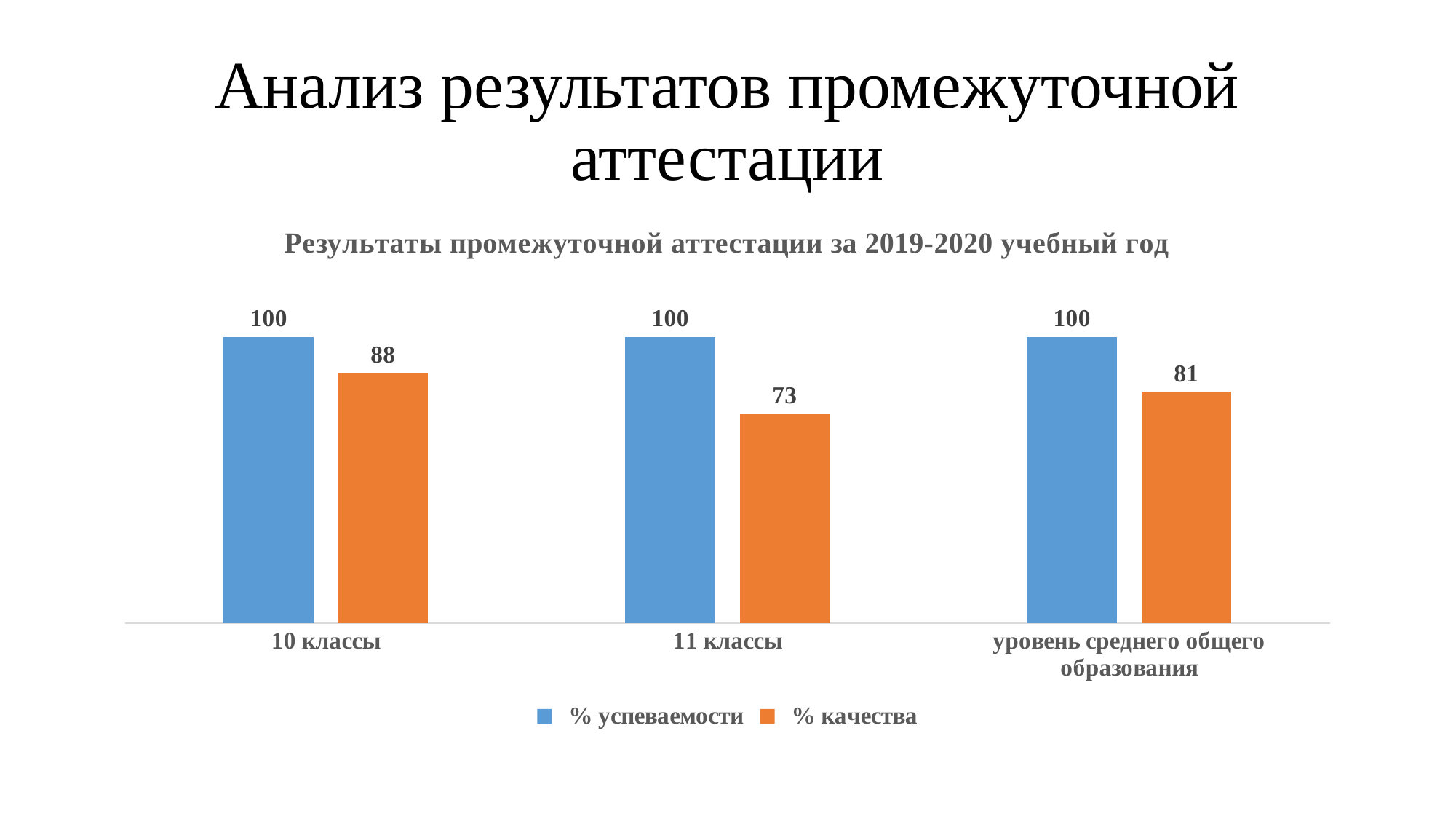
Which category has the lowest % качества? 11 классы What kind of chart is shown on the slide? Bar chart How many categories are shown on the x axis? 3 Which category has the highest % качества? 10 классы How many series does the legend list? 2 What is the value of % качества for уровень среднего общего образования? 81 What is the value of % качества for 10 классы? 88 What is the value of % качества for 11 классы? 73 What is the difference between % успеваемости and % качества for 11 классы? 27 What is the value of % успеваемости for 11 классы? 100 What is the difference in % качества between 10 классы and 11 классы? 15 Which is larger: % качества for 10 классы or for уровень среднего общего образования? 10 классы